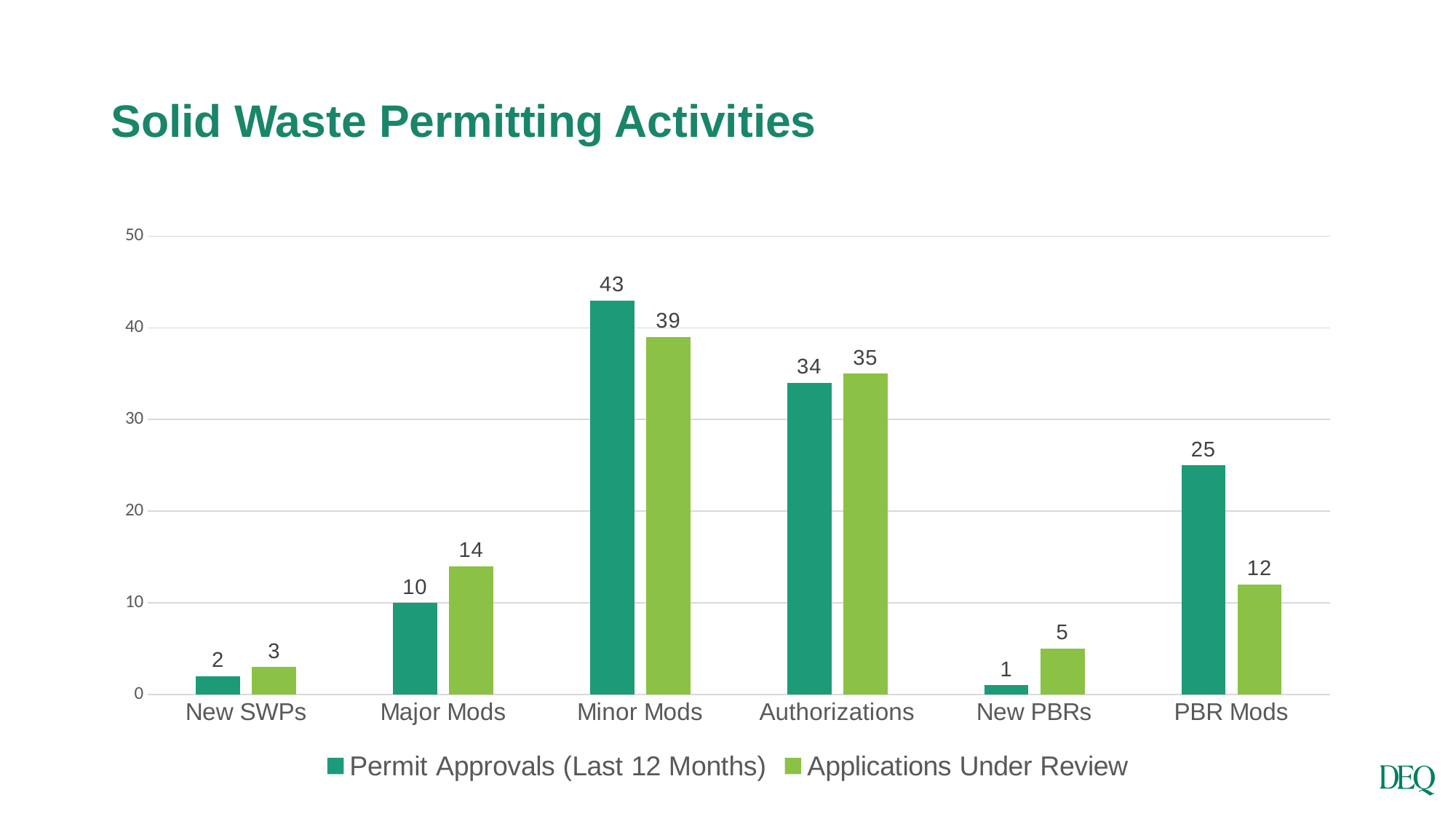
What is the value of Permit Approvals (Last 12 Months) for PBR Mods? 25 What is the value of Applications Under Review for Major Mods? 14 What is the title of the chart? Solid Waste Permitting Activities What is the value of Permit Approvals (Last 12 Months) for Minor Mods? 43 Which category has the highest value for Applications Under Review? Minor Mods Which category has the lowest value for Permit Approvals (Last 12 Months)? New PBRs How many categories are shown on the x axis? 6 Is the value of Applications Under Review for Minor Mods greater or less than 30? greater What is the difference between Permit Approvals (Last 12 Months) and Applications Under Review for PBR Mods? 13 For Authorizations, which is larger: Permit Approvals (Last 12 Months) or Applications Under Review? Applications Under Review What kind of chart is shown on the slide? Bar chart How many series does the legend list? 2